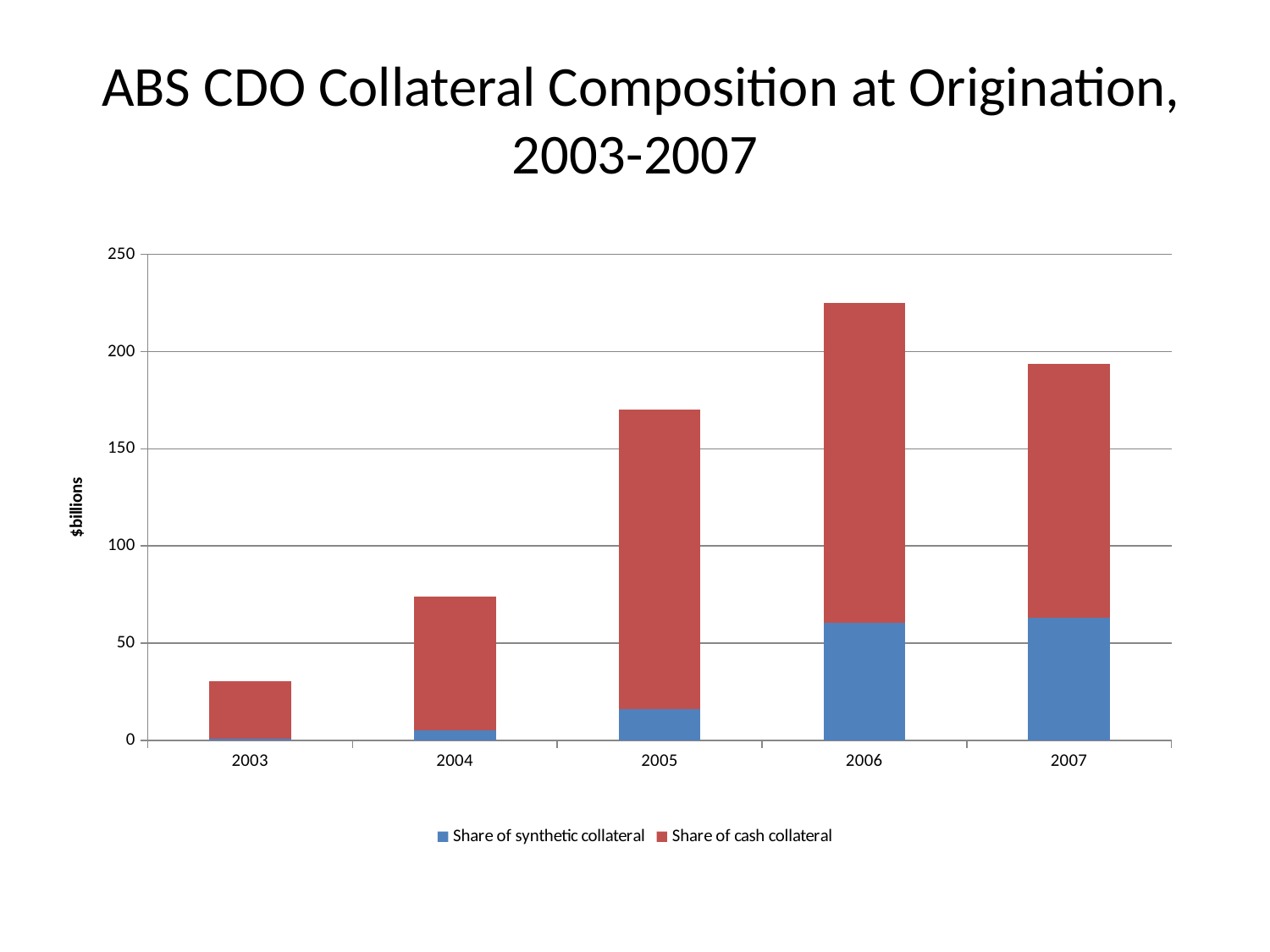
Do the total bars rise or fall from 2003 to 2006? rise Is the total bar for 2003 greater or less than 50? less Is the share of synthetic collateral for 2006 greater or less than 50? greater Is the total bar for 2006 greater or less than 200? greater How many years are shown on the x axis of the chart? 5 Which year has the tallest total bar? 2006 Which year has the shortest total bar? 2003 Which colour represents the share of cash collateral in the chart? Red Which year has the larger total bar, 2005 or 2007? 2007 How many series does the legend list? 2 What kind of chart is shown on the slide? Stacked bar chart